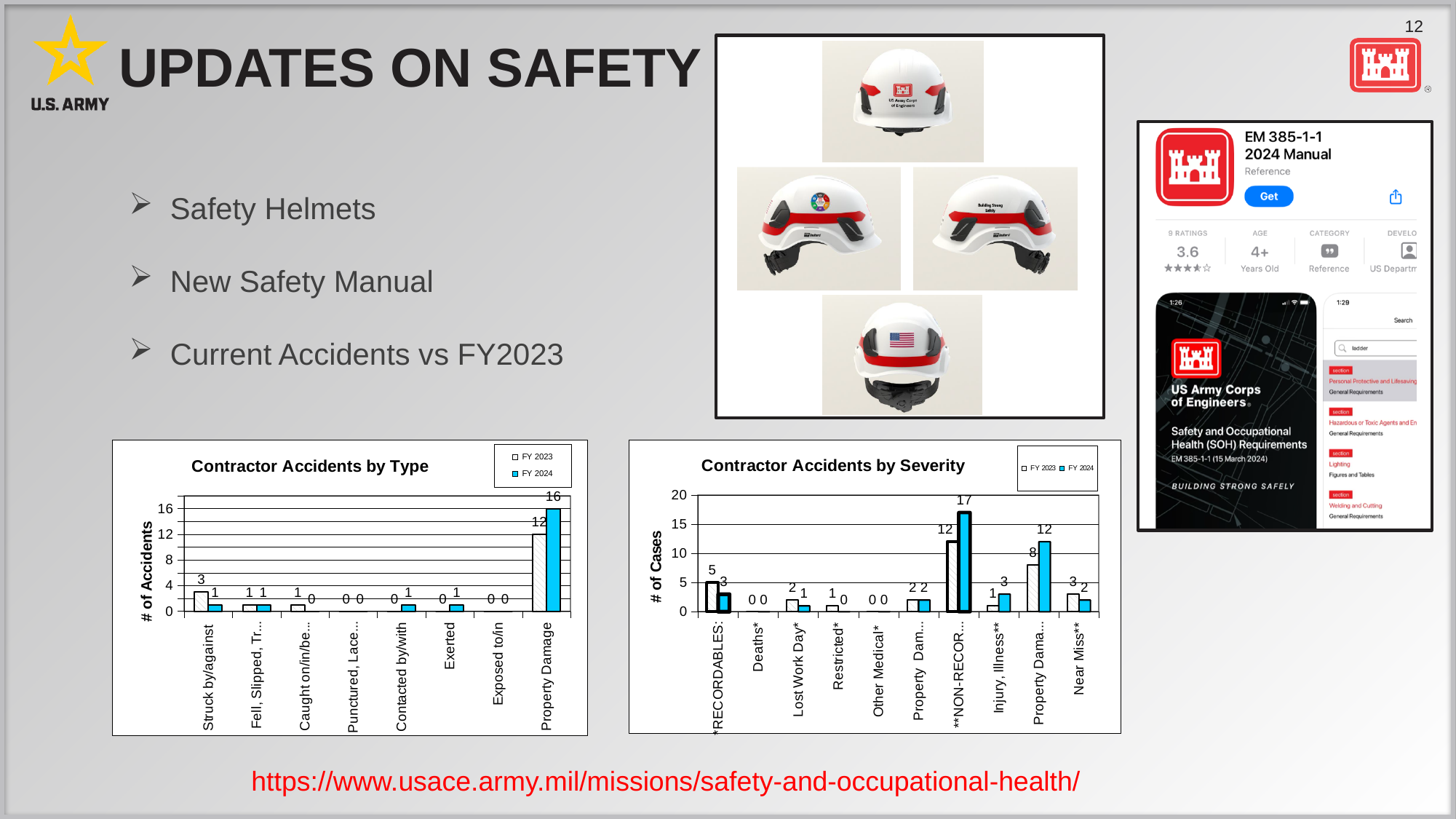
In the Contractor Accidents by Severity chart, what is the FY 2024 value for Near Miss**? 2 In the Contractor Accidents by Severity chart, what is the difference between the FY 2024 and FY 2023 values for **NON-RECOR...? 5 In the Contractor Accidents by Severity chart, what is the FY 2023 value for *RECORDABLES? 5 In the Contractor Accidents by Type chart, how many series does the legend list? 2 In the Contractor Accidents by Type chart, how many categories are shown on the x axis? 8 In the Contractor Accidents by Severity chart, which is larger for Injury, Illness**: FY 2023 or FY 2024? FY 2024 In the Contractor Accidents by Type chart, what is the FY 2023 value for Struck by/against? 3 What kind of chart is Contractor Accidents by Severity? Bar chart In the Contractor Accidents by Type chart, what is the difference between the FY 2024 and FY 2023 values for Property Damage? 4 In the Contractor Accidents by Type chart, what is the FY 2024 value for Property Damage? 16 In the Contractor Accidents by Severity chart, what is the y-axis label? # of Cases In the Contractor Accidents by Type chart, which category has the highest FY 2023 value? Property Damage